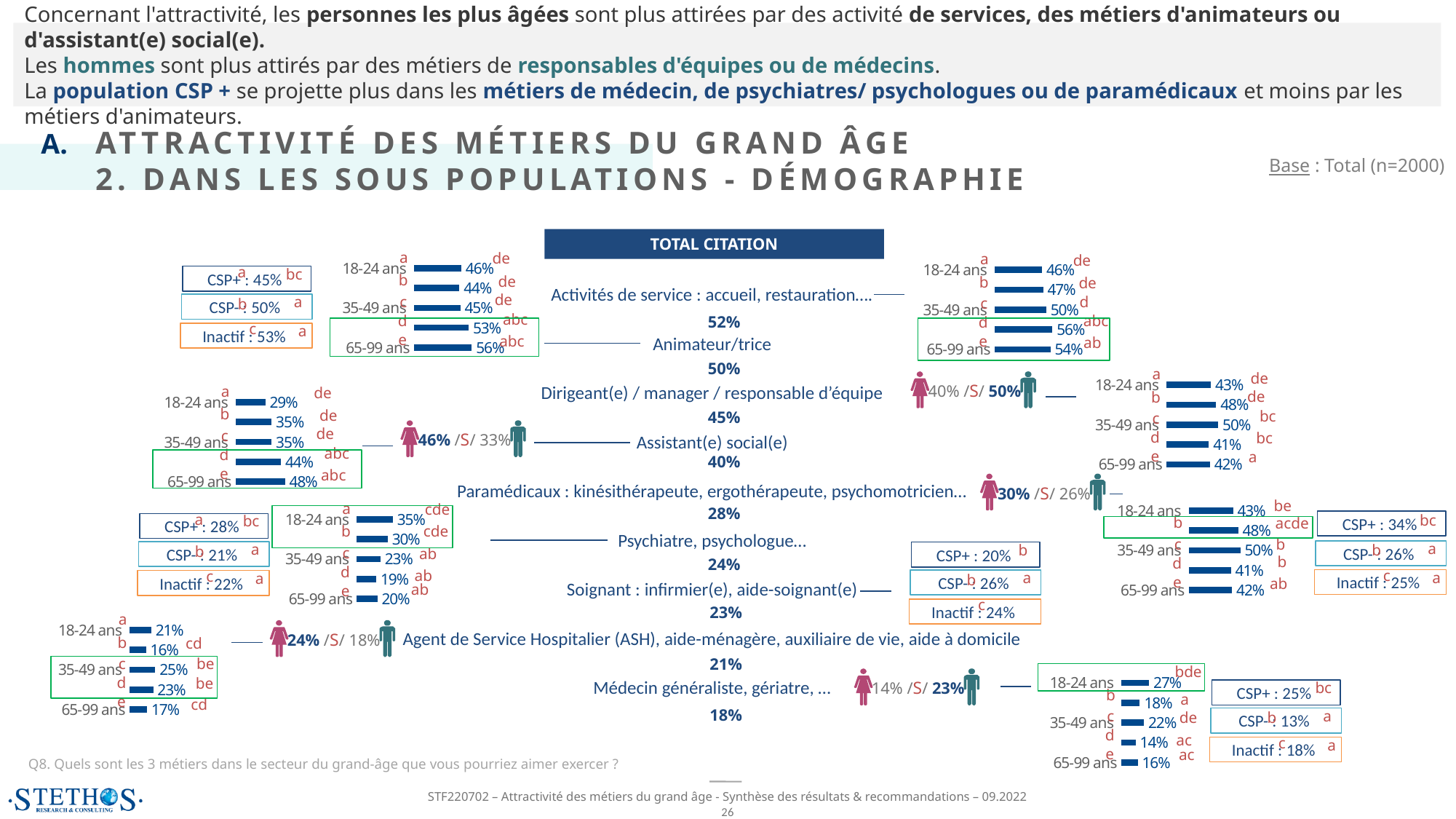
How many age-group bars are shown in the bar chart for Paramédicaux (lower right)? 5 In the TOTAL CITATION list in the centre of the slide, which profession has the lowest value? Médecin généraliste, gériatre, … In the age-group bar chart for Psychiatre, psychologue… (lower left), what is the value for 18-24 ans? 35% For Agent de Service Hospitalier (ASH), what is the value for women? 24% In the age-group bar chart for Animateur/trice (top right), which age group has the highest value? d (56%) For Dirigeant(e) / manager / responsable d'équipe, which is larger, the value for women or the value for men? men (50%) In the age-group bar chart for Médecin généraliste, gériatre, … (bottom right), which age group has the lowest value? d (14%) In the TOTAL CITATION list in the centre of the slide, what is the value for Activités de service : accueil, restauration…? 52% In the age-group bar chart for Assistant(e) social(e) (middle left), do the values rise or fall from 18-24 ans to 65-99 ans? rise In the age-group bar chart for Activités de service (top left), what is the value for 65-99 ans? 56% In the CSP boxes for Soignant : infirmier(e), aide-soignant(e), what is the value for CSP+? 20% In the age-group bar chart for Activités de service (top left), what is the difference between the 65-99 ans value and the 18-24 ans value? 10 percentage points